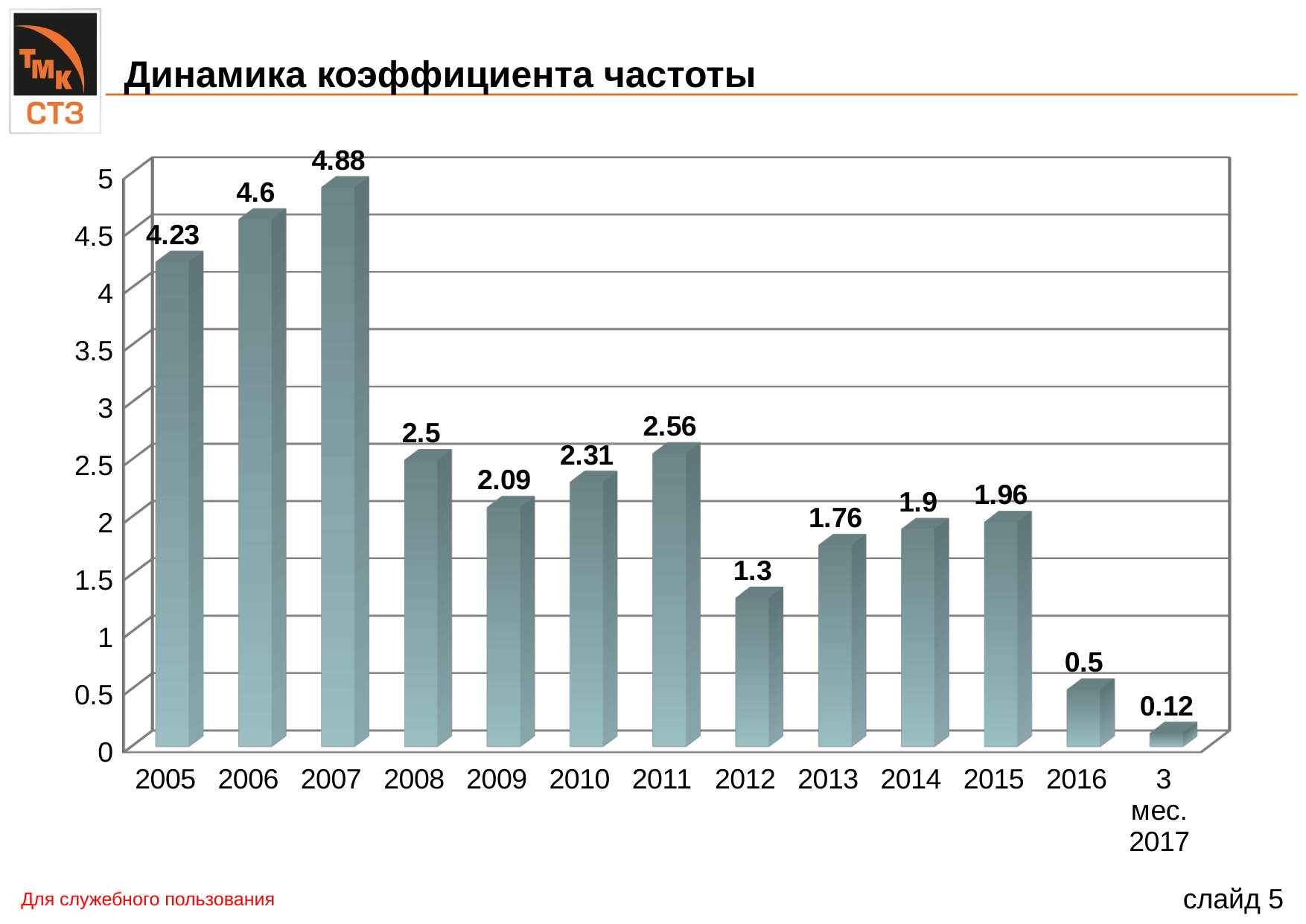
How many categories are shown on the x axis? 13 What is the value for 2007? 4.88 Which category has the lowest value? 3 мес. 2017 What is the title of the chart? Динамика коэффициента частоты Do the values generally rise or fall from 2007 to 3 мес. 2017? fall What is the value for 2012? 1.3 Is the value for 2013 greater or less than 2? less What kind of chart is shown on the slide? bar chart What is the difference between the values for 2007 and 2008? 2.38 What is the value for 3 мес. 2017? 0.12 Which is larger, the value for 2011 or the value for 2010? 2011 Which year has the highest value? 2007